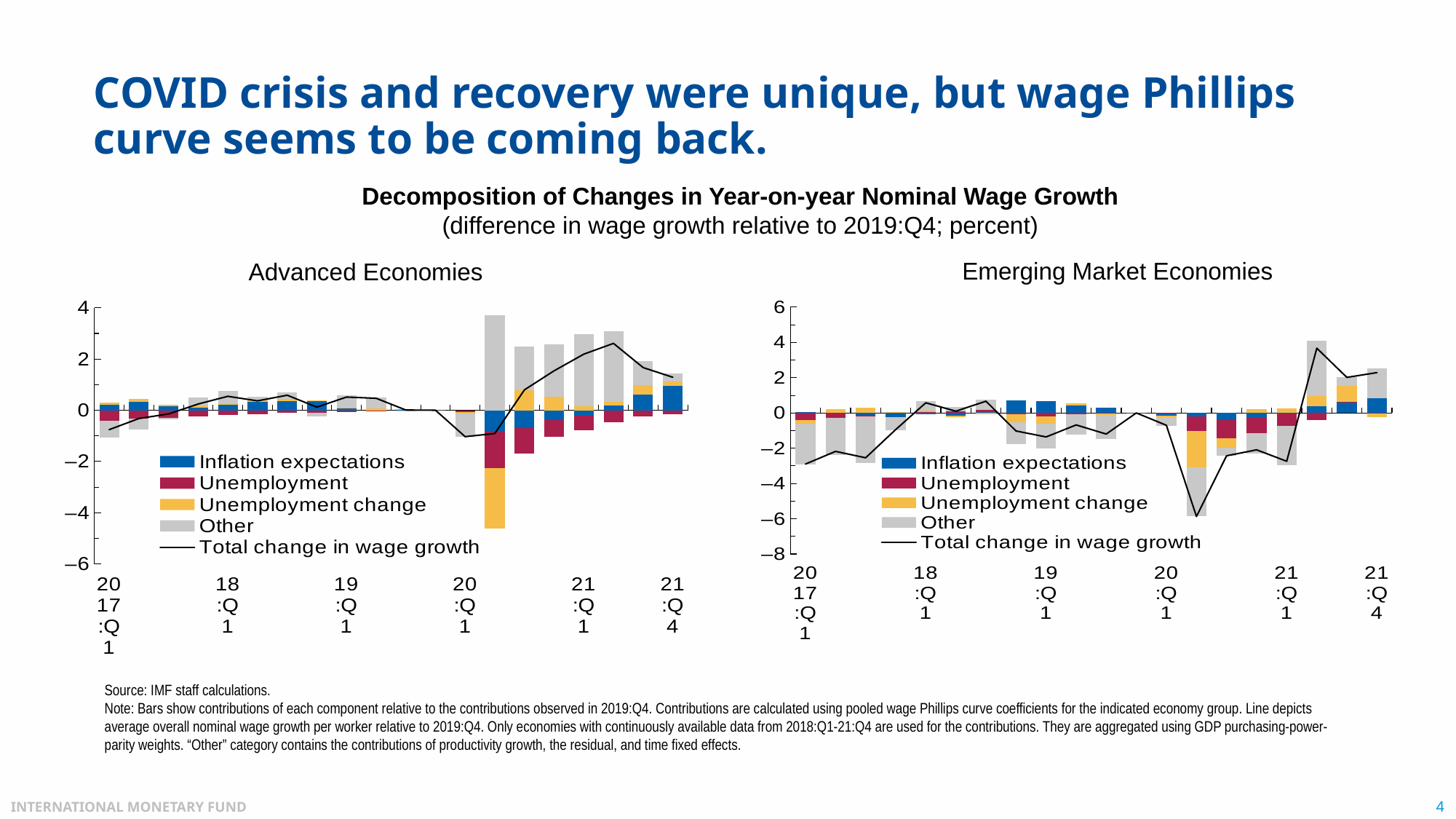
In the Emerging Market Economies chart, is the lowest point of the Total change in wage growth line greater or less than -4? less What is the main title shown above the two charts? Decomposition of Changes in Year-on-year Nominal Wage Growth In the Emerging Market Economies chart, does the Total change in wage growth line rise or fall between 2021:Q1 and 2021:Q4? rise In the Advanced Economies chart, what colour represents the "Other" component? grey In the Advanced Economies chart, does the Total change in wage growth line rise or fall between 2020:Q1 and 2021:Q1? rise In the Emerging Market Economies chart, is the Total change in wage growth line higher at 2021:Q4 or at 2020:Q1? 2021:Q4 In the Advanced Economies chart, is the top of the tallest grey Other bar greater or less than 2? greater How many entries does the legend of the Emerging Market Economies chart list? 5 In the Emerging Market Economies chart, is the highest point of the Total change in wage growth line greater or less than 2? greater What kind of chart is the Advanced Economies chart? combination bar and line chart How many x-axis labels are shown on the Emerging Market Economies chart? 6